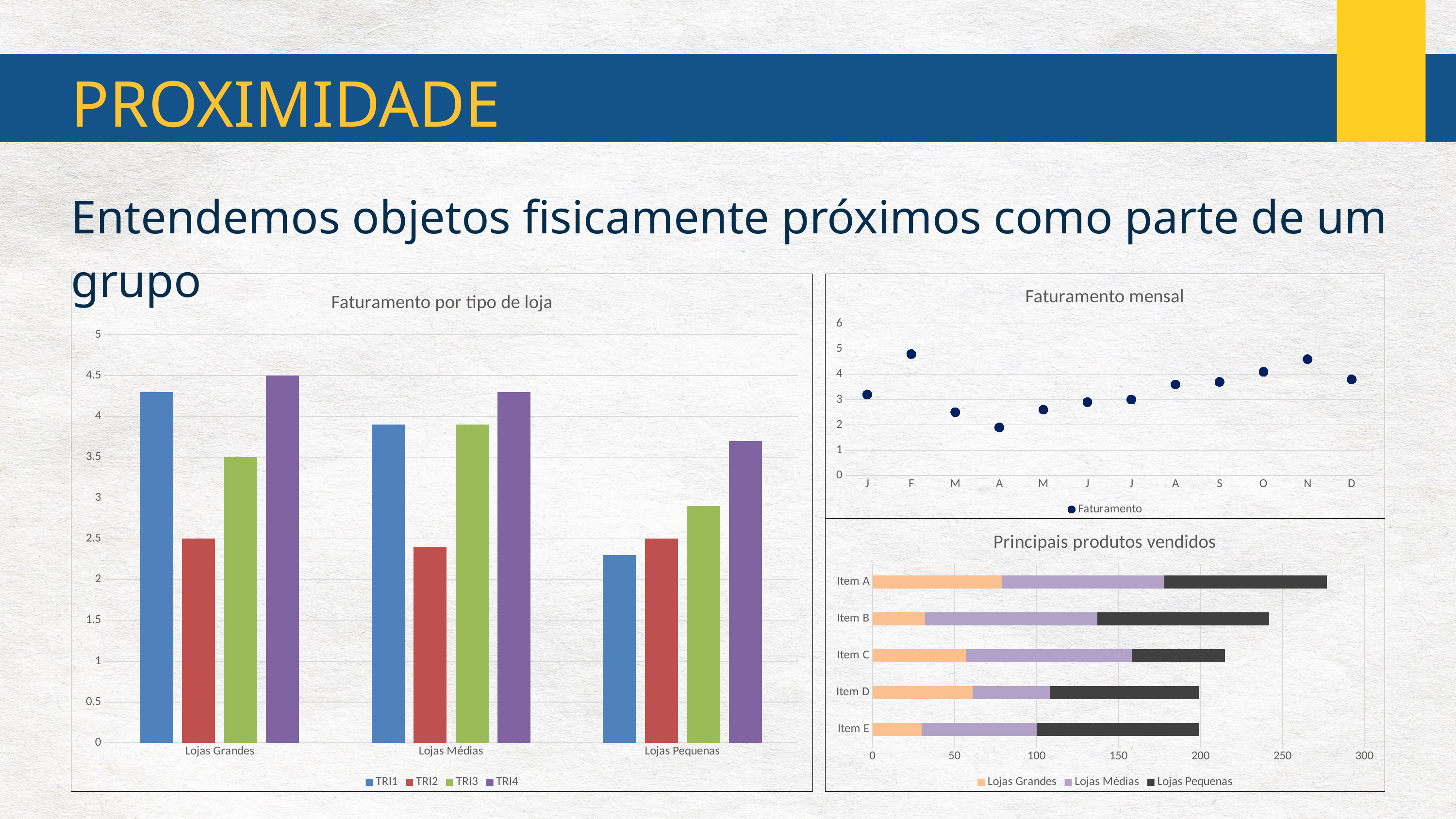
In 'Faturamento por tipo de loja', which series has the lowest value for Lojas Pequenas? TRI1 In 'Faturamento por tipo de loja', is the TRI1 value for Lojas Grandes greater or less than 4? greater How many store-type categories are shown in 'Faturamento por tipo de loja'? 3 In 'Principais produtos vendidos', which item has the longest total bar? Item A What kind of chart is 'Faturamento por tipo de loja'? bar chart In 'Faturamento por tipo de loja', is the TRI2 value for Lojas Médias greater or less than 3? less In 'Faturamento por tipo de loja', which series has the highest value for Lojas Grandes? TRI4 How many series does the legend of 'Faturamento por tipo de loja' list? 4 In 'Faturamento mensal', which month has the lowest value? A (April) In 'Faturamento mensal', is the value for F greater or less than 4? greater In 'Faturamento por tipo de loja', which is larger for Lojas Pequenas: TRI3 or TRI4? TRI4 How many series does the legend of 'Principais produtos vendidos' list? 3